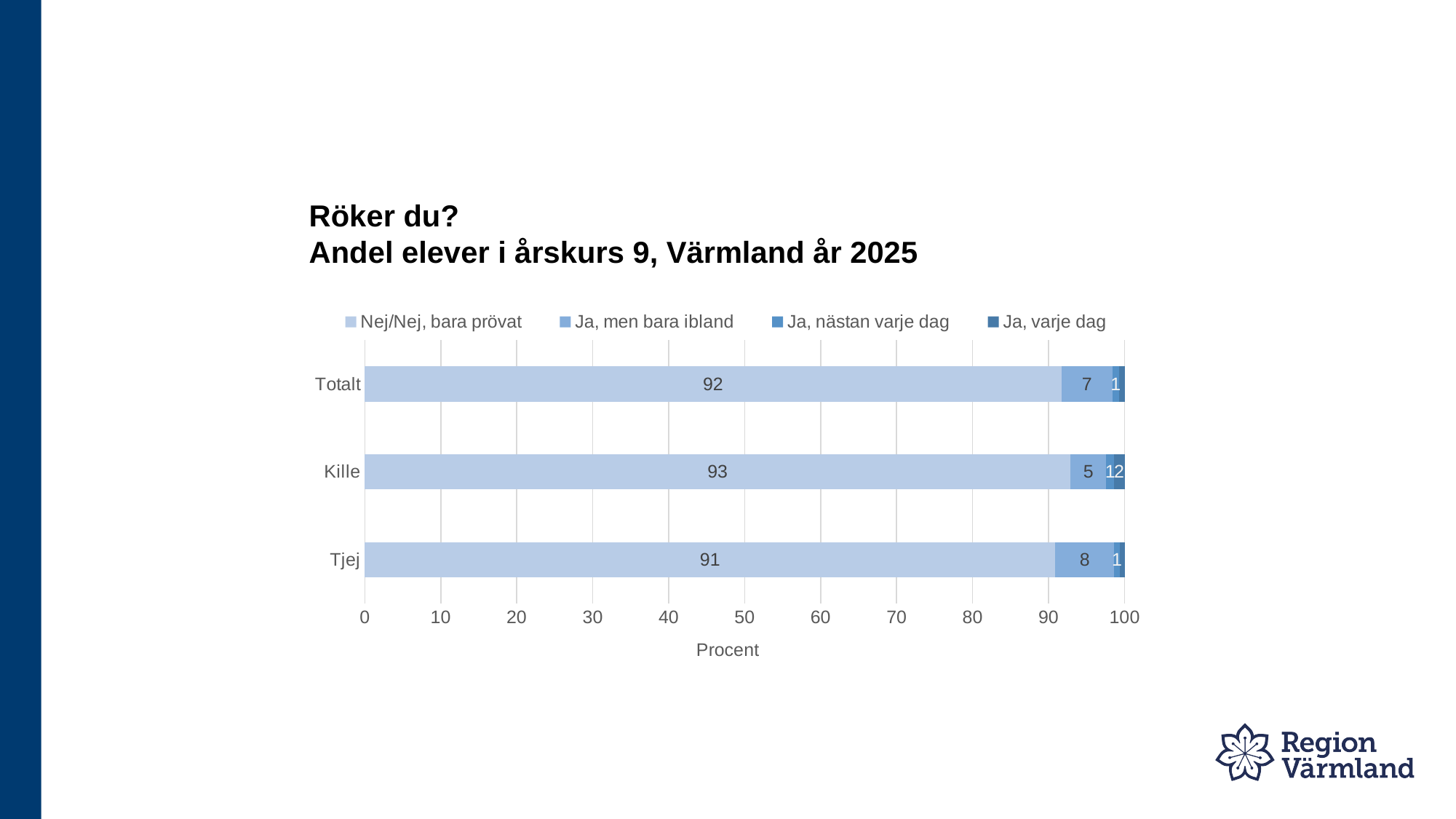
What is the value for "Nej/Nej, bara prövat" among Kille? 93 What is the value for "Nej/Nej, bara prövat" among Tjej? 91 How many categories are shown on the vertical axis? 3 Which category has the lowest value for "Ja, men bara ibland"? Kille How many series does the legend list? 4 Which category has the highest value for "Nej/Nej, bara prövat"? Kille Is the "Nej/Nej, bara prövat" value for Tjej greater or less than 90? greater What kind of chart is shown on the slide? Stacked bar chart What is the value for "Ja, men bara ibland" among Tjej? 8 What percentage of all students (Totalt) answered "Nej/Nej, bara prövat"? 92 What is the difference between Tjej and Kille for "Ja, men bara ibland"? 3 What is the value for "Ja, men bara ibland" among Kille? 5